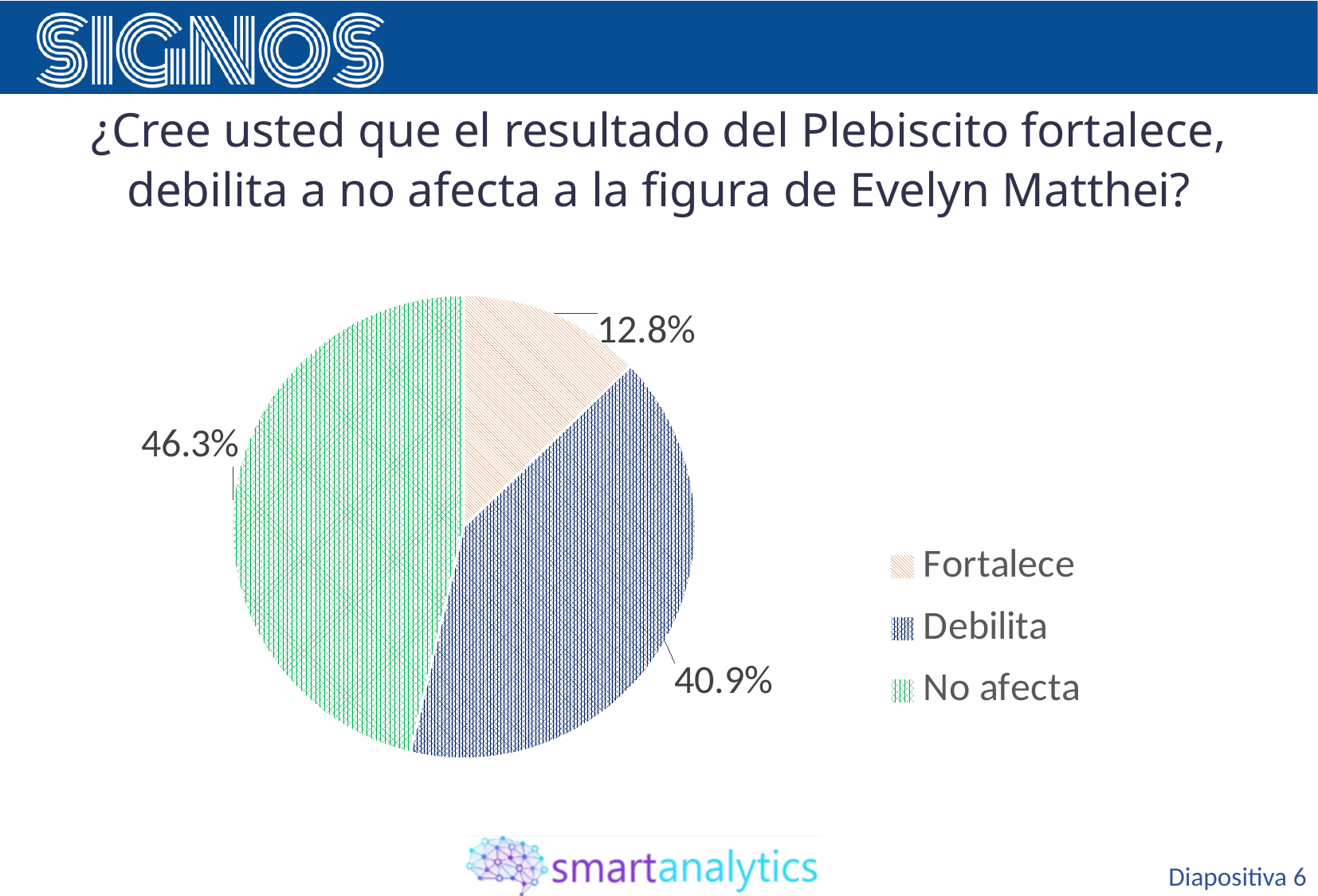
Which legend entry is listed second? Debilita What share of respondents answered "No afecta"? 46.3% What kind of chart is shown on the slide? Pie chart What is the difference in percentage points between "Debilita" and "Fortalece"? 28.1 What share of respondents answered "Fortalece"? 12.8% What is the difference in percentage points between "No afecta" and "Debilita"? 5.4 Which response has the smallest share of the pie? Fortalece What share of respondents answered "Debilita"? 40.9% Which response has the largest share of the pie? No afecta How many entries does the legend list? 3 How many slices does the pie chart have? 3 Which is larger, the share for "Debilita" or the share for "Fortalece"? Debilita